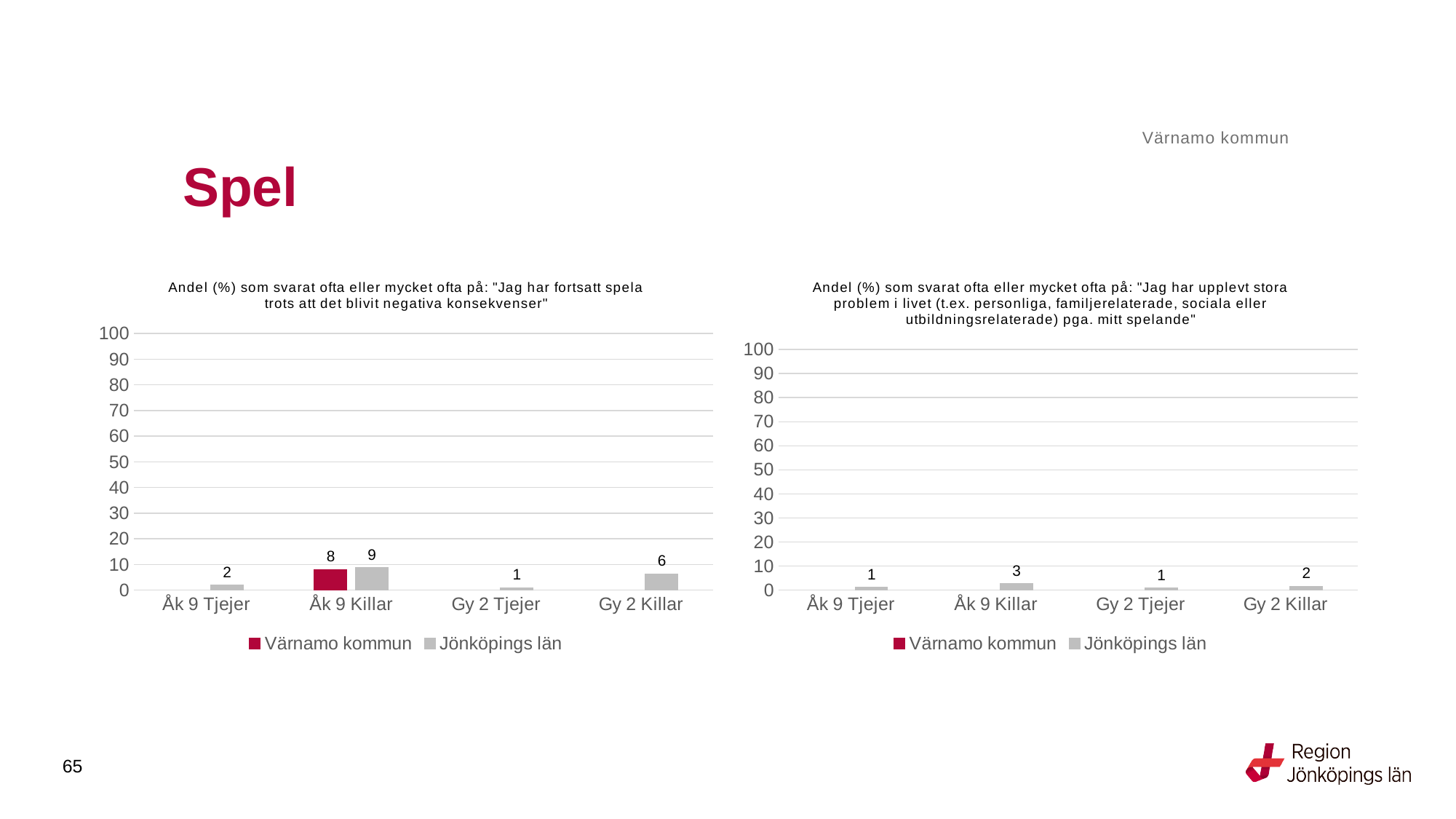
In the left chart, which category has the lowest Jönköpings län value? Gy 2 Tjejer In the right chart, is the Jönköpings län value for Åk 9 Killar greater or less than 10? less In the right chart, which category has the highest Jönköpings län value? Åk 9 Killar In the left chart, which category has the highest Jönköpings län value? Åk 9 Killar In the right chart, what is the value for Jönköpings län for Åk 9 Killar? 3 How many series does the legend of the left chart list? 2 In the left chart, what is the value for Jönköpings län for Åk 9 Killar? 9 In the left chart, what is the value for Värnamo kommun for Åk 9 Killar? 8 What kind of chart is the right chart? bar chart In the left chart, what is the value for Jönköpings län for Gy 2 Killar? 6 In the right chart, what is the value for Jönköpings län for Gy 2 Killar? 2 In the left chart, what is the difference between the Jönköpings län and Värnamo kommun values for Åk 9 Killar? 1